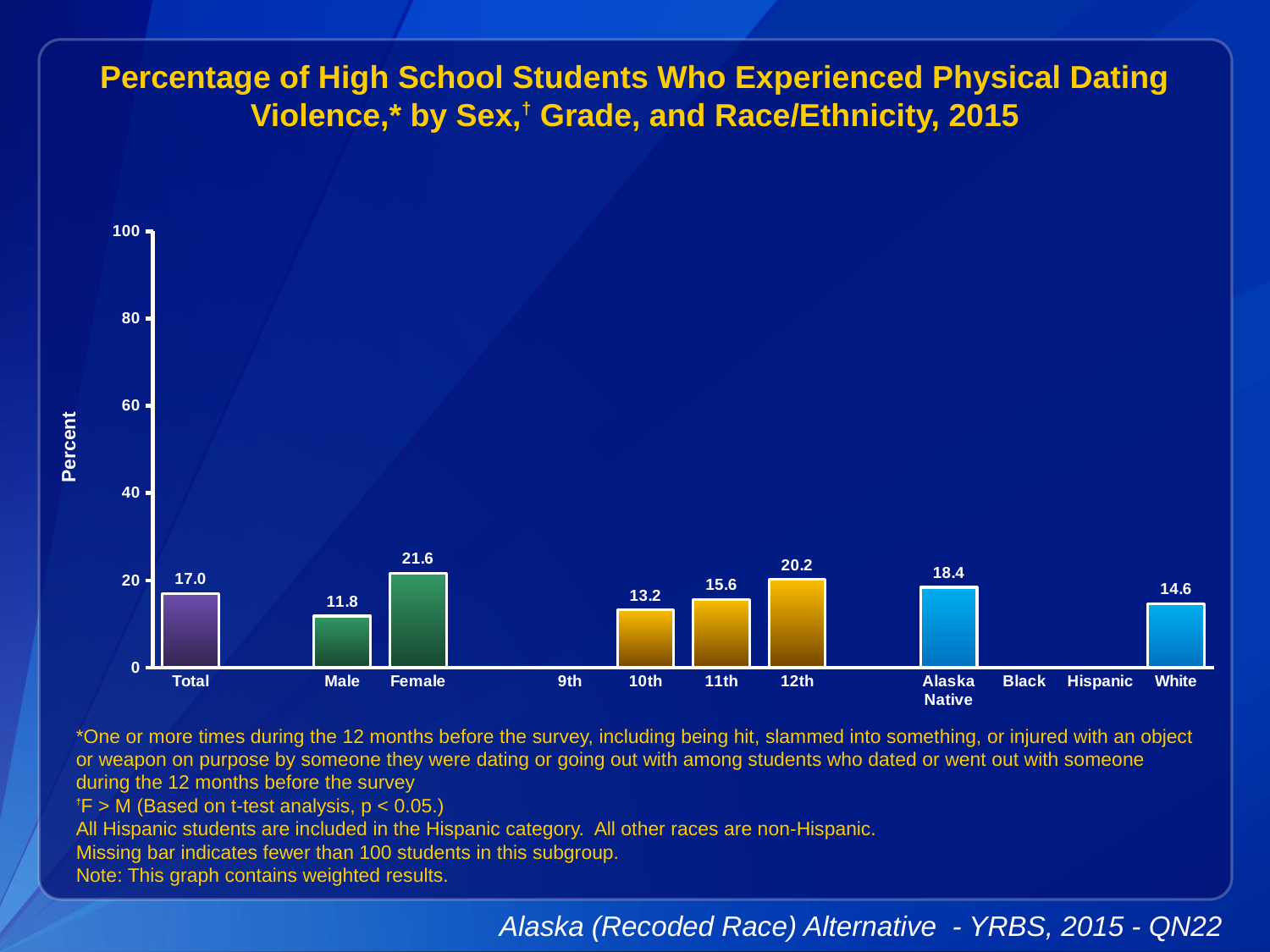
Which category has the highest value? Female Which is larger, the value for 10th grade or the value for 11th grade? 11th Do the values rise or fall from 10th grade to 12th grade? rise What kind of chart is shown? bar chart Is the value for White greater or less than 20? less Which categories on the x axis have no bar? 9th, Black, Hispanic What is the value for Alaska Native? 18.4 What is the value for Total? 17.0 What is the value for Female? 21.6 Which category with a bar has the lowest value? Male What is the difference between the Female and Male values? 9.8 What is the value for 12th grade? 20.2